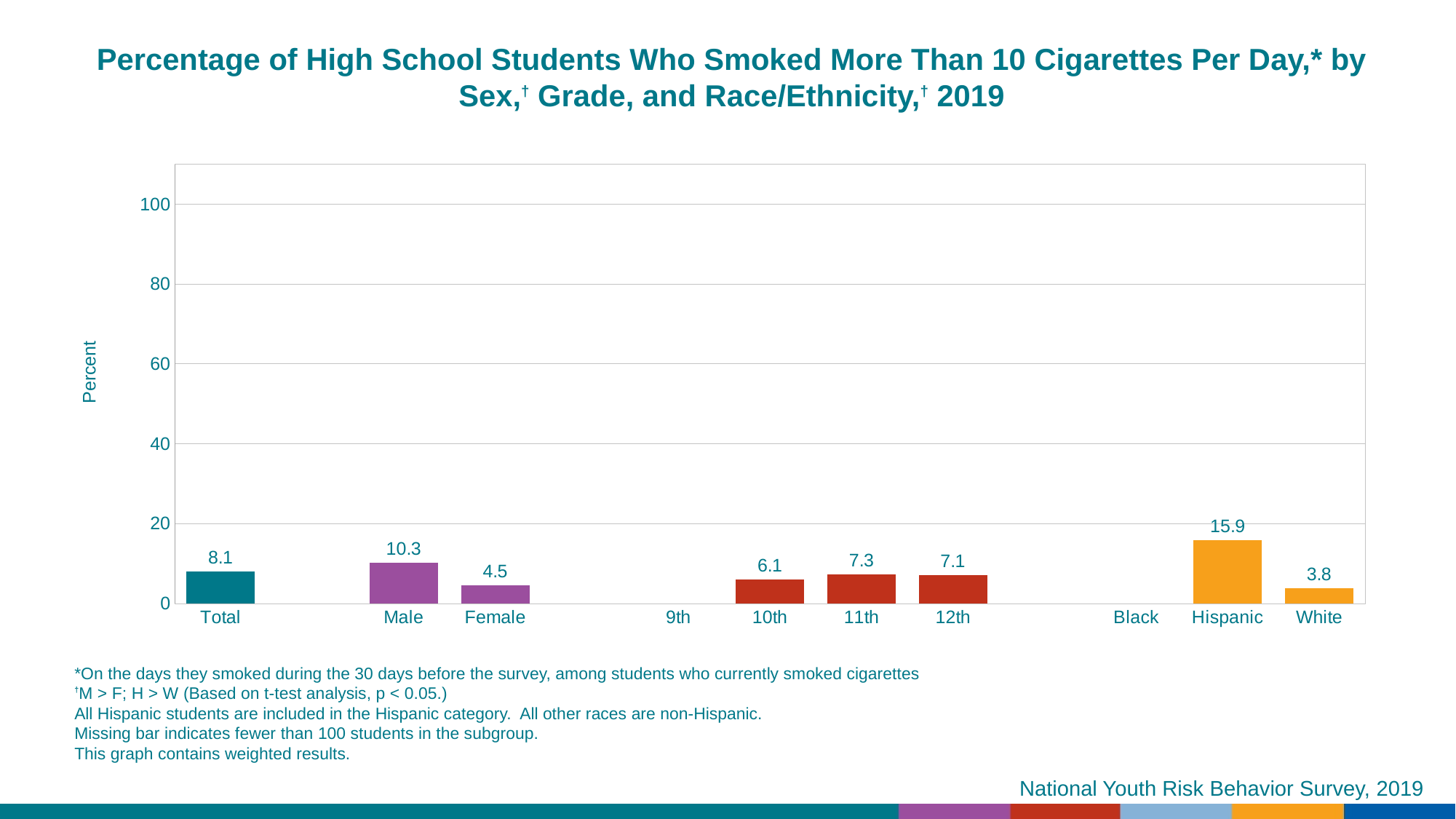
Is the value for Hispanic greater or less than 20? less Which category with a plotted bar has the lowest value? White What is the value for Total? 8.1 What kind of chart is shown? bar chart What is the value for Male? 10.3 What is the value for Hispanic? 15.9 What is the value for 11th grade? 7.3 What is the difference between the Male and Female values? 5.8 Which categories on the x axis have no bar shown? 9th and Black How many categories have a plotted bar? 9 Which category has the highest value? Hispanic Which is larger, the value for 10th grade or 12th grade? 12th grade